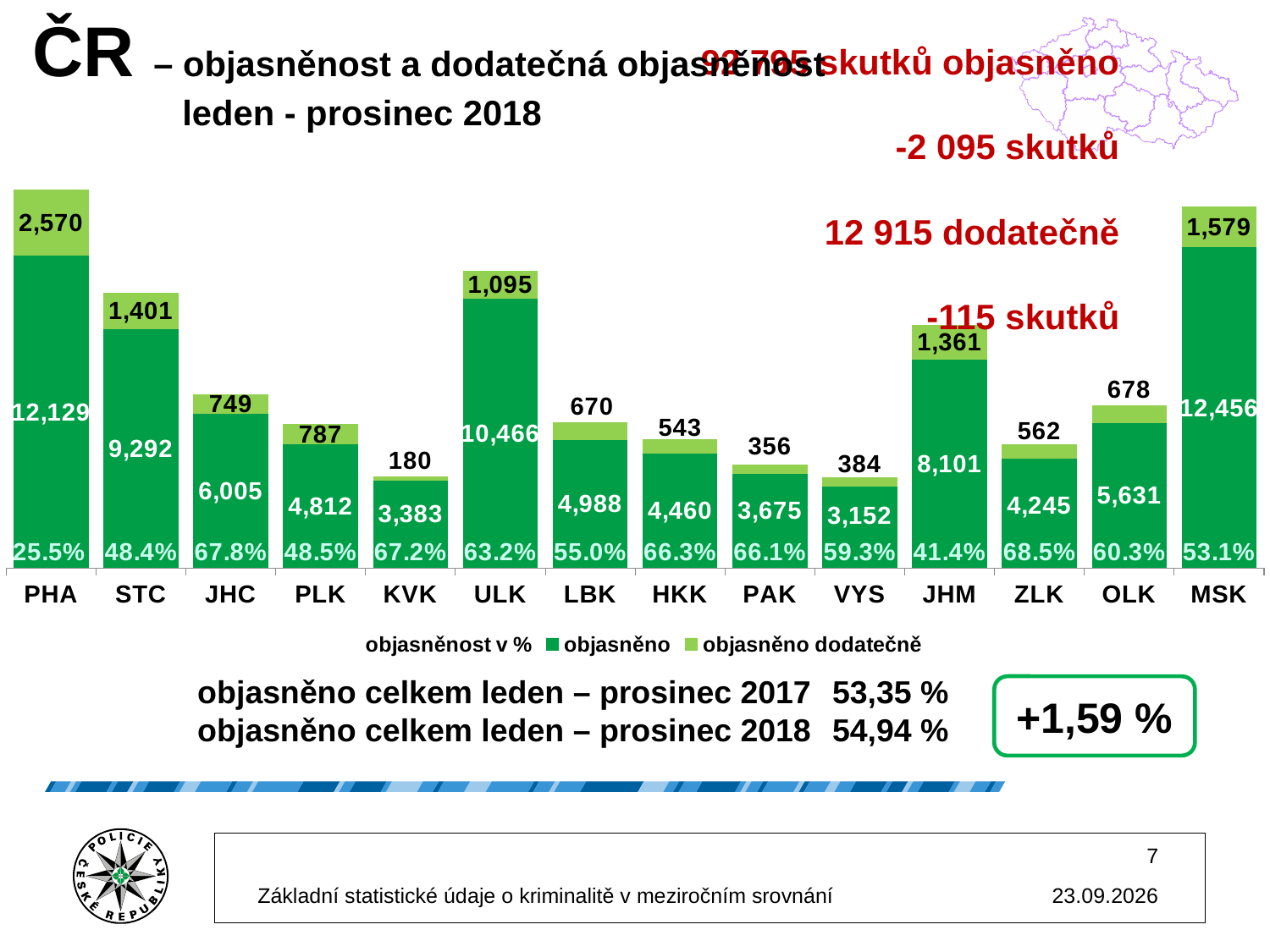
What is the 'objasněno' value for ULK? 10,466 How many entries does the chart legend list? 3 What is the total of the stacked bar for MSK (objasněno plus objasněno dodatečně)? 14,035 What is the difference between the 'objasněno' values for PHA and STC? 2,837 How many regions are shown on the x axis of the chart? 14 Which is larger, the 'objasněno dodatečně' value for LBK or for OLK? OLK Which region has the lowest 'objasněno dodatečně' value? KVK What is the 'objasněno dodatečně' value for JHM? 1,361 Which region has the highest 'objasněno' value? MSK Which region has the lowest 'objasněnost v %' value? PHA What is the 'objasněnost v %' value shown for ZLK? 68.5% What type of chart is shown on the slide? Stacked bar chart